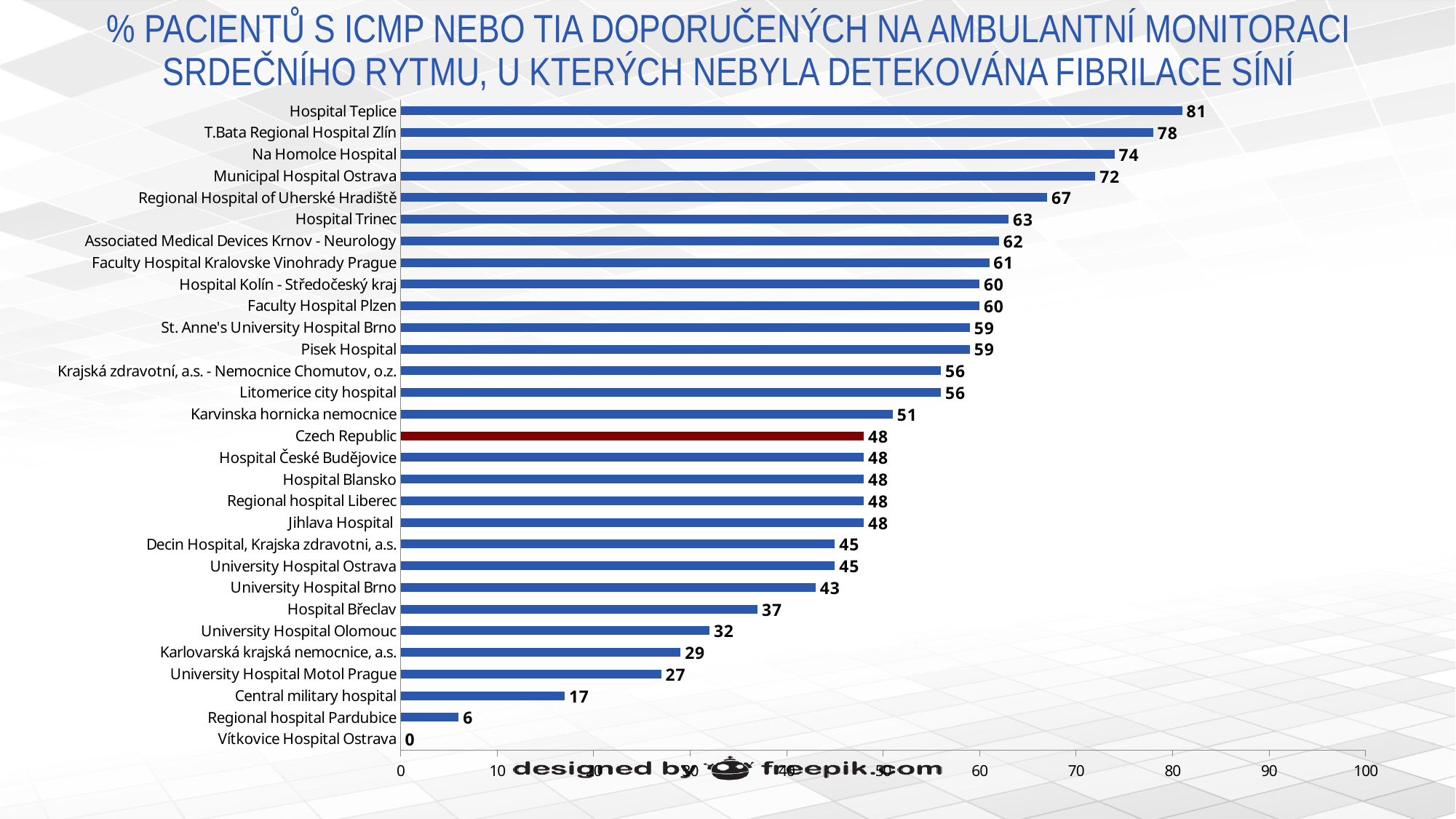
Which category has the highest value? Hospital Teplice Which bar is shown in a different colour (dark red) from the others? Czech Republic What kind of chart is shown on the slide? bar chart What is the value for Regional hospital Pardubice? 6 What is the difference between the values for Hospital Teplice and Czech Republic? 33 Which category has the lowest value? Vítkovice Hospital Ostrava Which is larger, the value for Hospital Trinec or the value for University Hospital Brno? Hospital Trinec What is the value for Czech Republic? 48 What is the value for Hospital Teplice? 81 How many categories are plotted on the chart? 30 Is the value for Na Homolce Hospital greater or less than 70? greater What is the value for University Hospital Motol Prague? 27